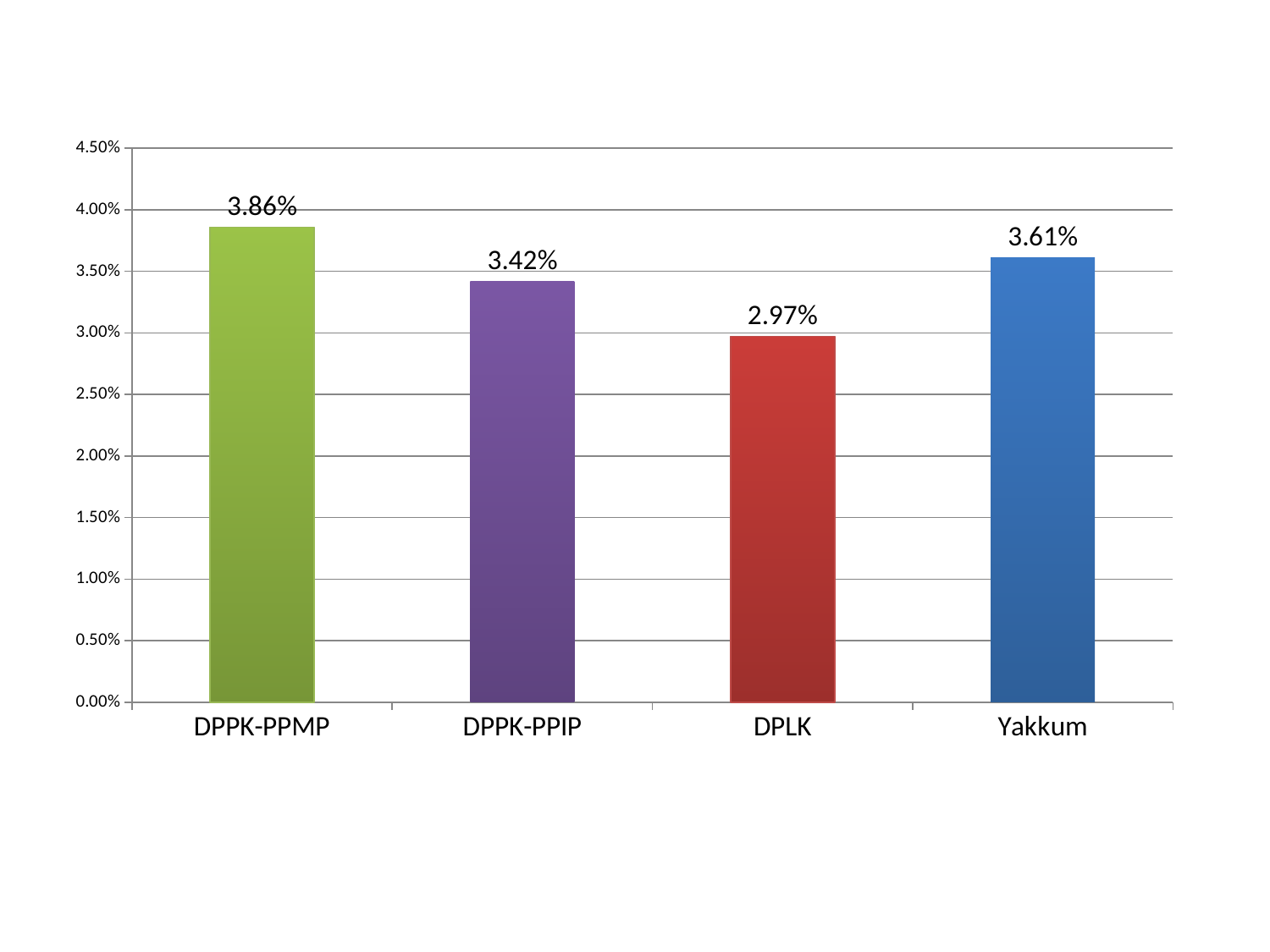
What is the value for Yakkum? 3.61% What is the value for DPPK-PPIP? 3.42% Which category has the highest value? DPPK-PPMP What is the value for DPPK-PPMP? 3.86% How many categories are shown on the chart? 4 Which is larger, the value for DPPK-PPIP or the value for Yakkum? Yakkum Which category has the lowest value? DPLK What kind of chart is shown on the slide? bar chart What is the value for DPLK? 2.97% What is the difference between the values for DPPK-PPMP and DPLK? 0.89% What is the difference between the values for Yakkum and DPPK-PPIP? 0.19% Is the value for DPLK greater or less than 3.00%? less